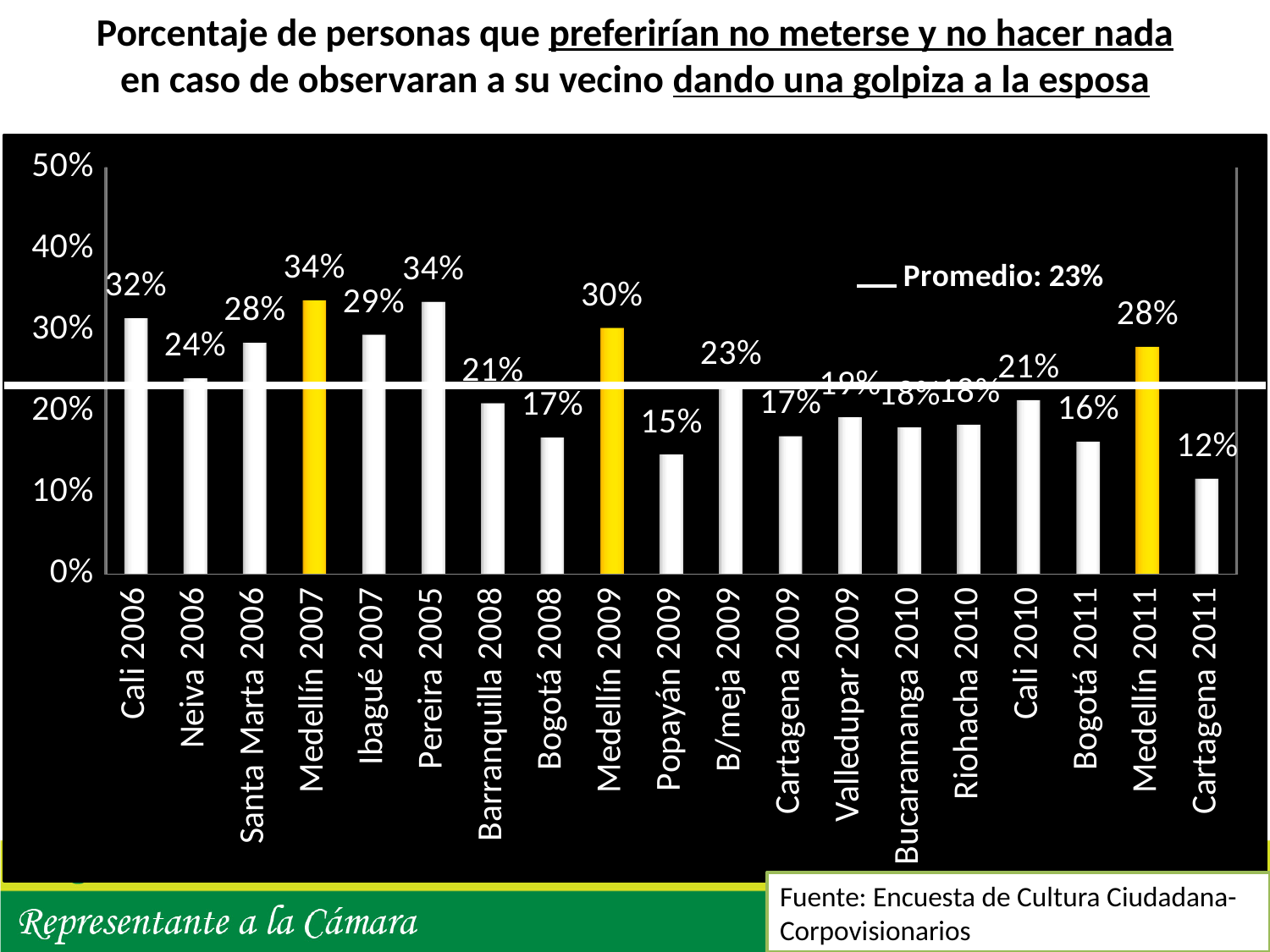
What is the value for Cartagena 2011? 12% Is the value for Bogotá 2011 greater or less than 20%? less What is the value for Medellín 2009? 30% Which category has the lowest value? Cartagena 2011 What is the difference between the values for Pereira 2005 and Barranquilla 2008? 13% What is the value for Popayán 2009? 15% Which is larger, the value for Ibagué 2007 or the value for Neiva 2006? Ibagué 2007 What average value (Promedio) is indicated by the horizontal line? 23% How many categories are shown on the x axis? 19 What is the difference between the values for Medellín 2007 and Medellín 2011? 6% What is the value for Cali 2006? 32% What kind of chart is shown on the slide? bar chart